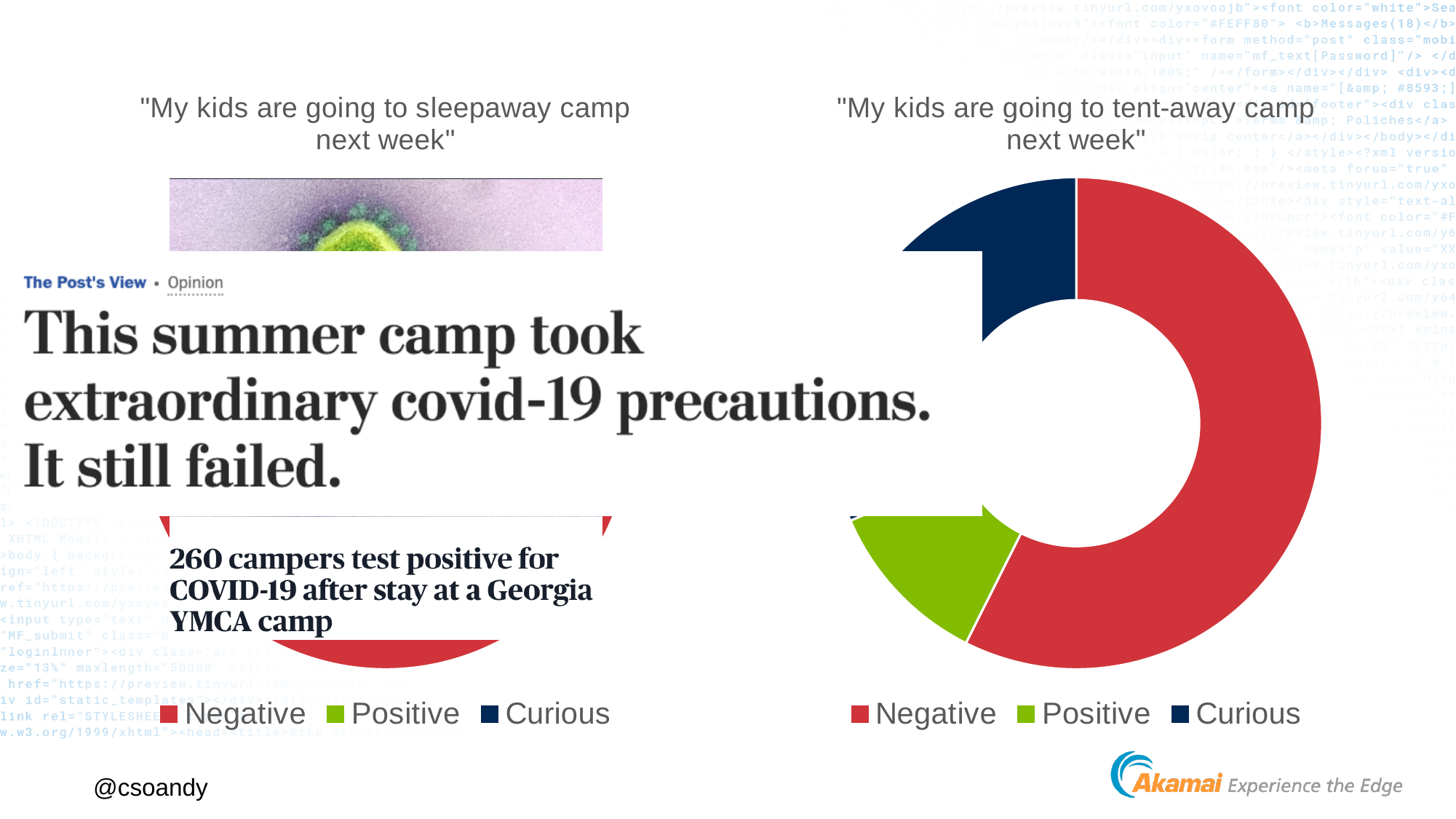
In the right-hand chart ("My kids are going to tent-away camp next week"), which is larger, Negative or Curious? Negative In the right-hand chart ("My kids are going to tent-away camp next week"), which is larger, Negative or Positive? Negative How many categories does the legend of the left-hand chart ("My kids are going to sleepaway camp next week") list? 3 How many categories does the legend of the right-hand chart list? 3 What kind of chart is shown on the right side of the slide, under "My kids are going to tent-away camp next week"? doughnut chart In the right-hand chart, what colour represents the Curious category? dark blue In the right-hand chart ("My kids are going to tent-away camp next week"), which category has the largest slice? Negative What is the title of the chart on the right side of the slide? "My kids are going to tent-away camp next week"